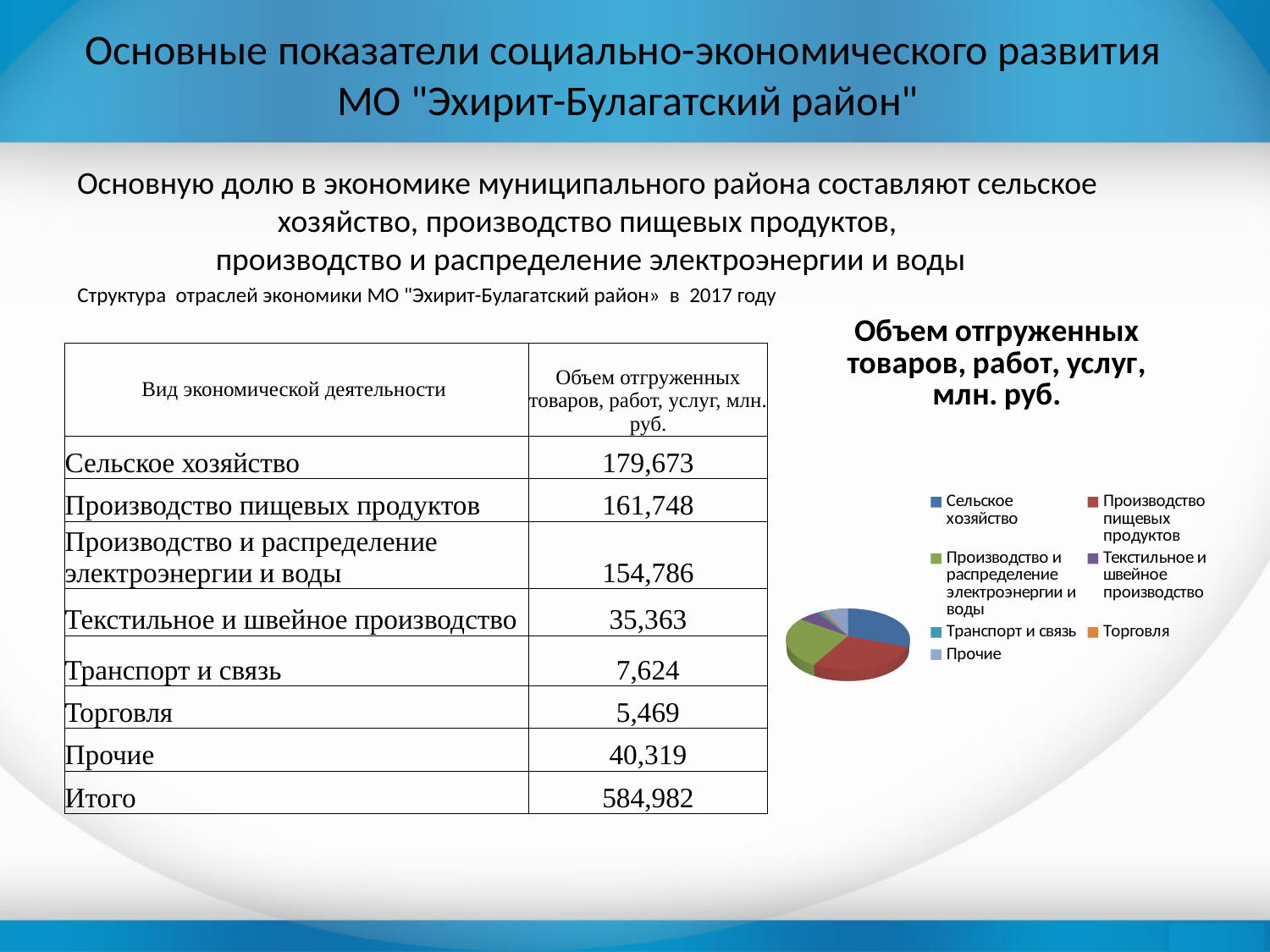
Which category has the smallest value? Торговля How many entries does the legend of the pie chart list? 7 What is the value for Текстильное и швейное производство (млн. руб.)? 35,363 Which category has the largest value? Сельское хозяйство What is the difference between the values for Сельское хозяйство and Производство пищевых продуктов? 17,925 What kind of chart is shown on the slide? pie chart What colour is the slice for Сельское хозяйство in the pie chart? blue What is the value for Сельское хозяйство (млн. руб.)? 179,673 How many categories (slices) does the pie chart have? 7 Which is larger: the value for Прочие or the value for Транспорт и связь? Прочие What is the value for Торговля (млн. руб.)? 5,469 What is the title of the pie chart? Объем отгруженных товаров, работ, услуг, млн. руб.